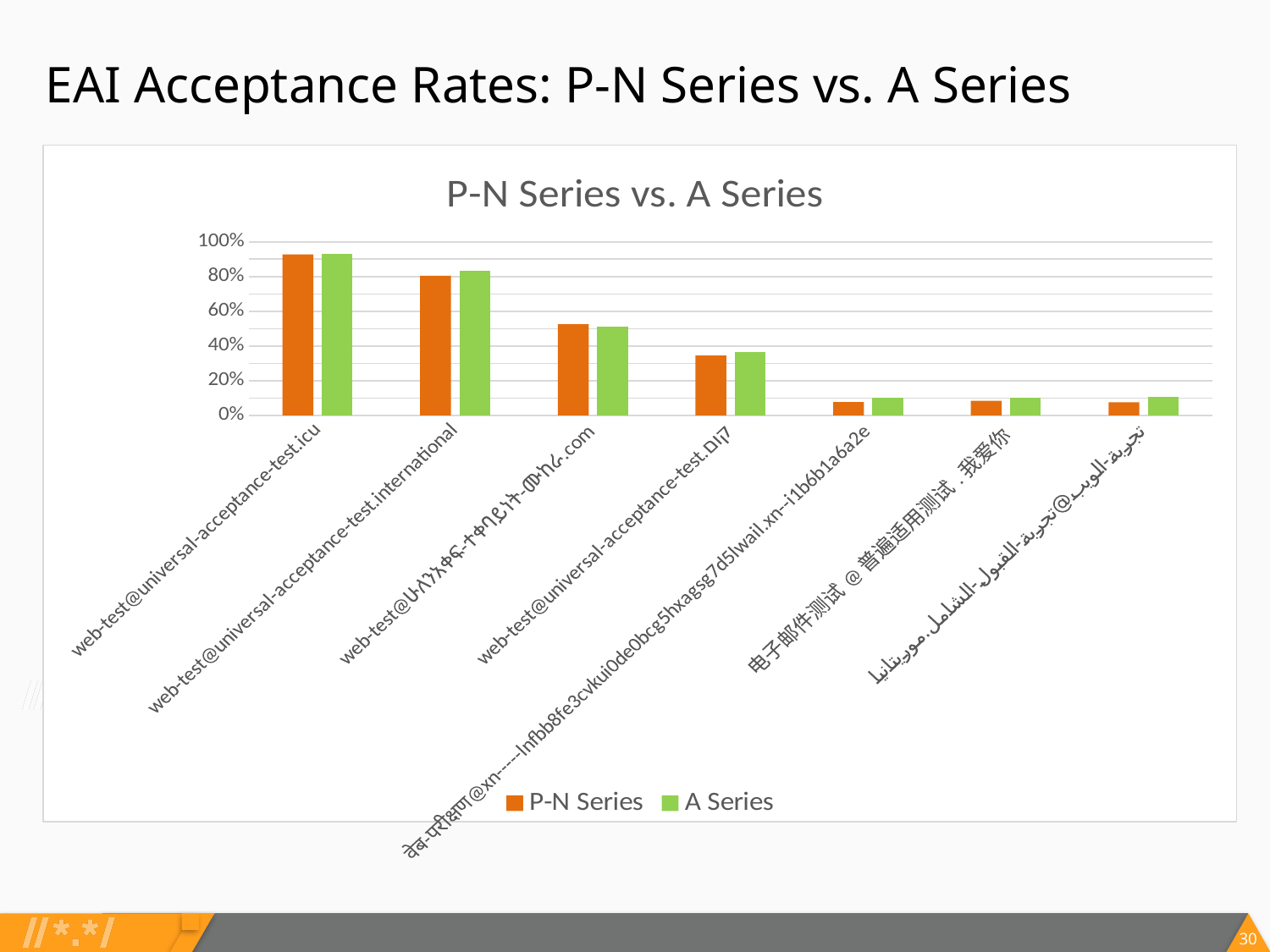
How many series does the legend list? 2 Which category has the highest value for the P-N Series? web-test@universal-acceptance-test.icu Which colour represents the A Series in the legend? green How many categories are plotted along the x axis? 7 For the A Series, which is larger: the value for web-test@universal-acceptance-test.icu or the value for web-test@universal-acceptance-test.international? web-test@universal-acceptance-test.icu Is the P-N Series value for 电子邮件测试 @ 普遍适用测试 . 我爱你 greater or less than 20%? less What kind of chart is shown on the slide? bar chart Is the P-N Series value for web-test@universal-acceptance-test.international greater or less than 60%? greater What is the title of the chart? P-N Series vs. A Series Is the P-N Series value for web-test@universal-acceptance-test.icu greater or less than 80%? greater Do the values generally rise or fall moving from left to right along the x axis? fall